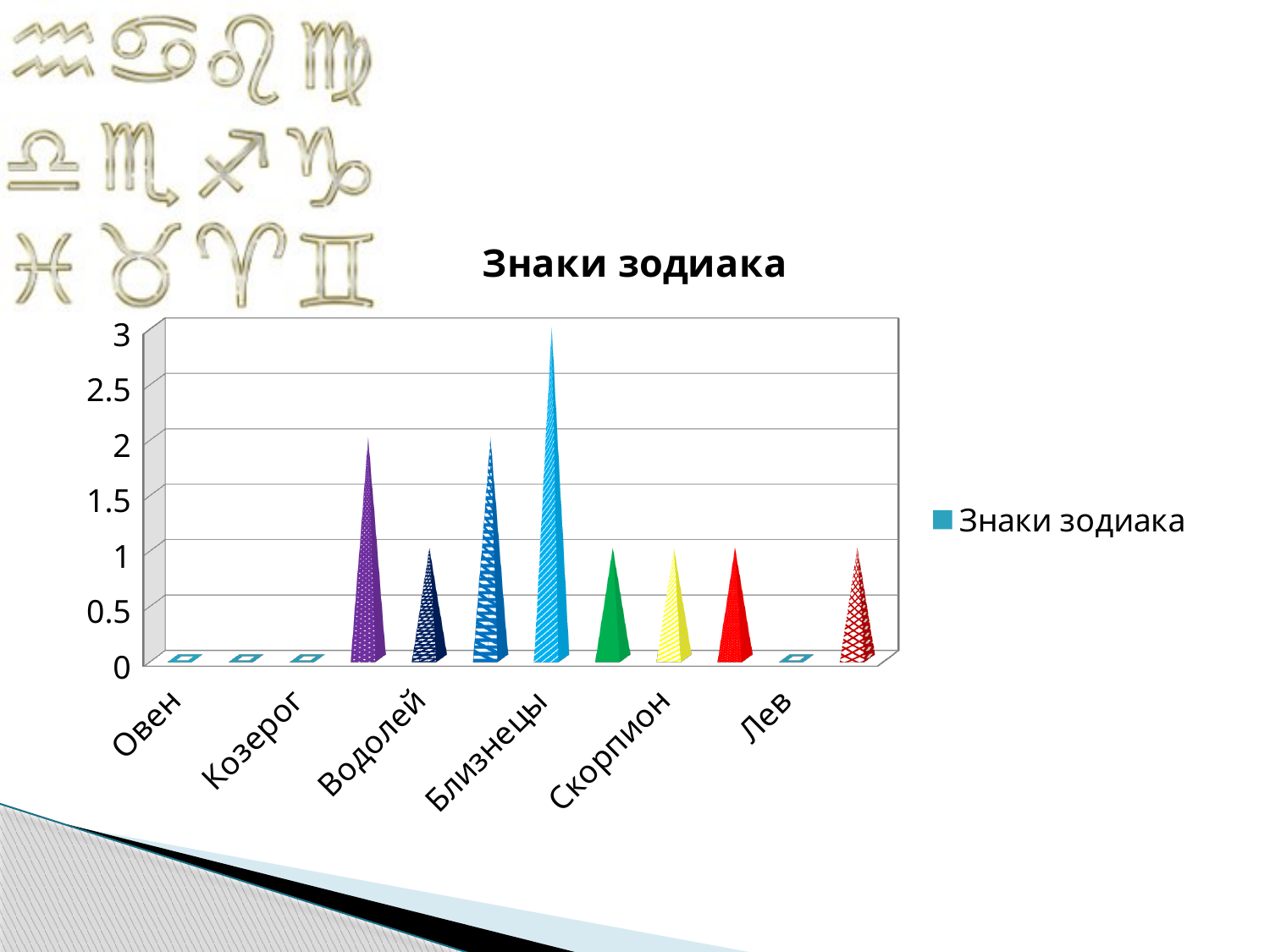
What kind of chart is shown on the slide? bar chart What is the value for Близнецы? 3 Which labelled category has the highest value? Близнецы What is the value for Скорпион? 1 What is the value for Лев? 0 What is the difference between the values for Близнецы and Водолей? 2 Which is larger, the value for Близнецы or the value for Скорпион? Близнецы What is the value for Овен? 0 Is the value for Близнецы greater or less than 2.5? greater What is the value for Водолей? 1 What is the title of the chart? Знаки зодиака How many series does the legend list? 1